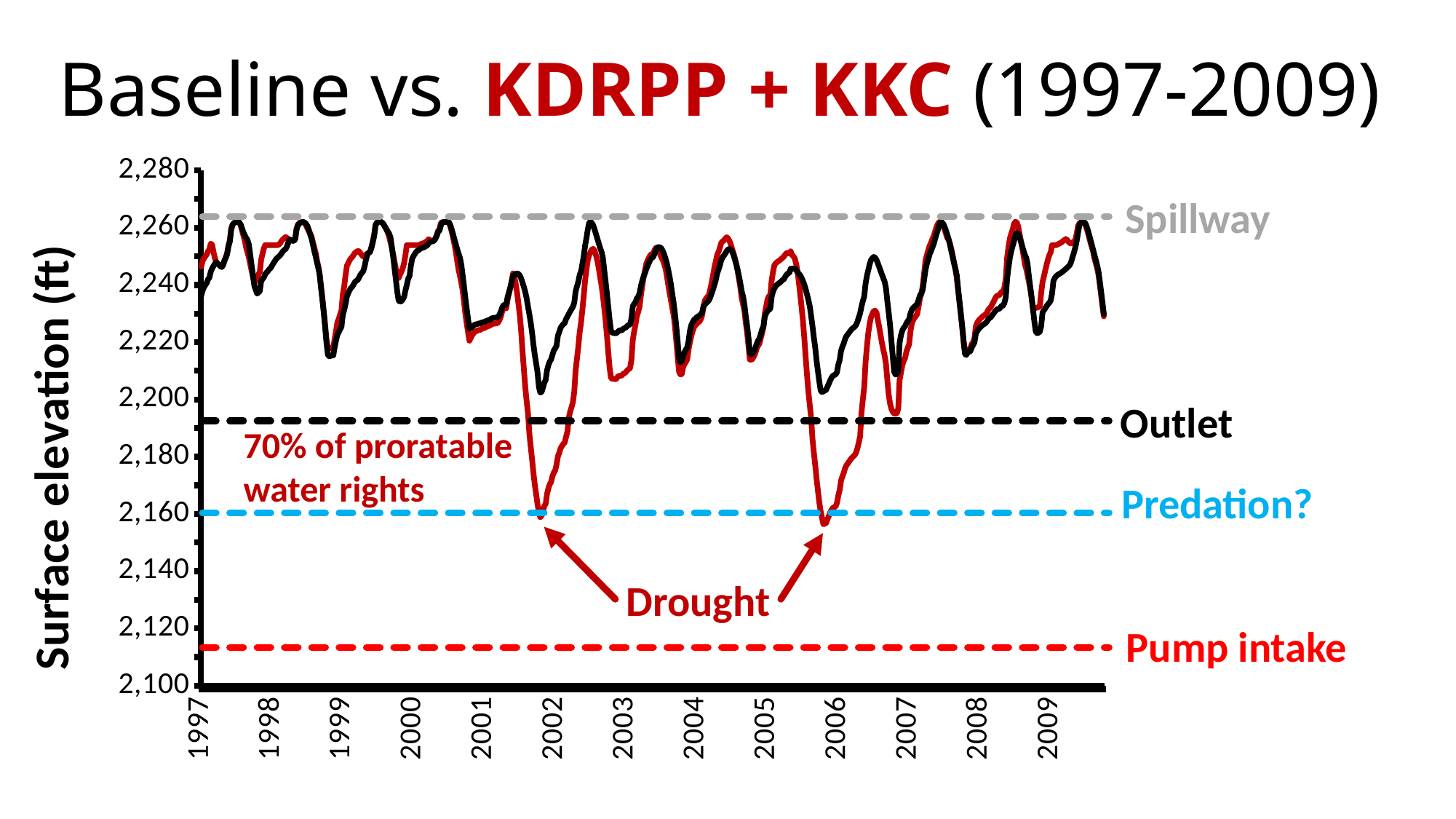
What does the gray dashed line near the top of the chart represent? Spillway Around 2006, does the red KDRPP + KKC line fall below the Outlet line? yes Is the Outlet dashed line greater or less than 2,180? greater During the 2002 drought, which series drops lower, Baseline or KDRPP + KKC? KDRPP + KKC Is the Pump intake dashed line greater or less than 2,120? less Is the lowest point of the black Baseline line around 2002 greater or less than 2,180? greater How many year labels are shown along the x axis? 13 What kind of chart is shown on the slide? line chart What annotation labels the two deep dips in the red line? Drought